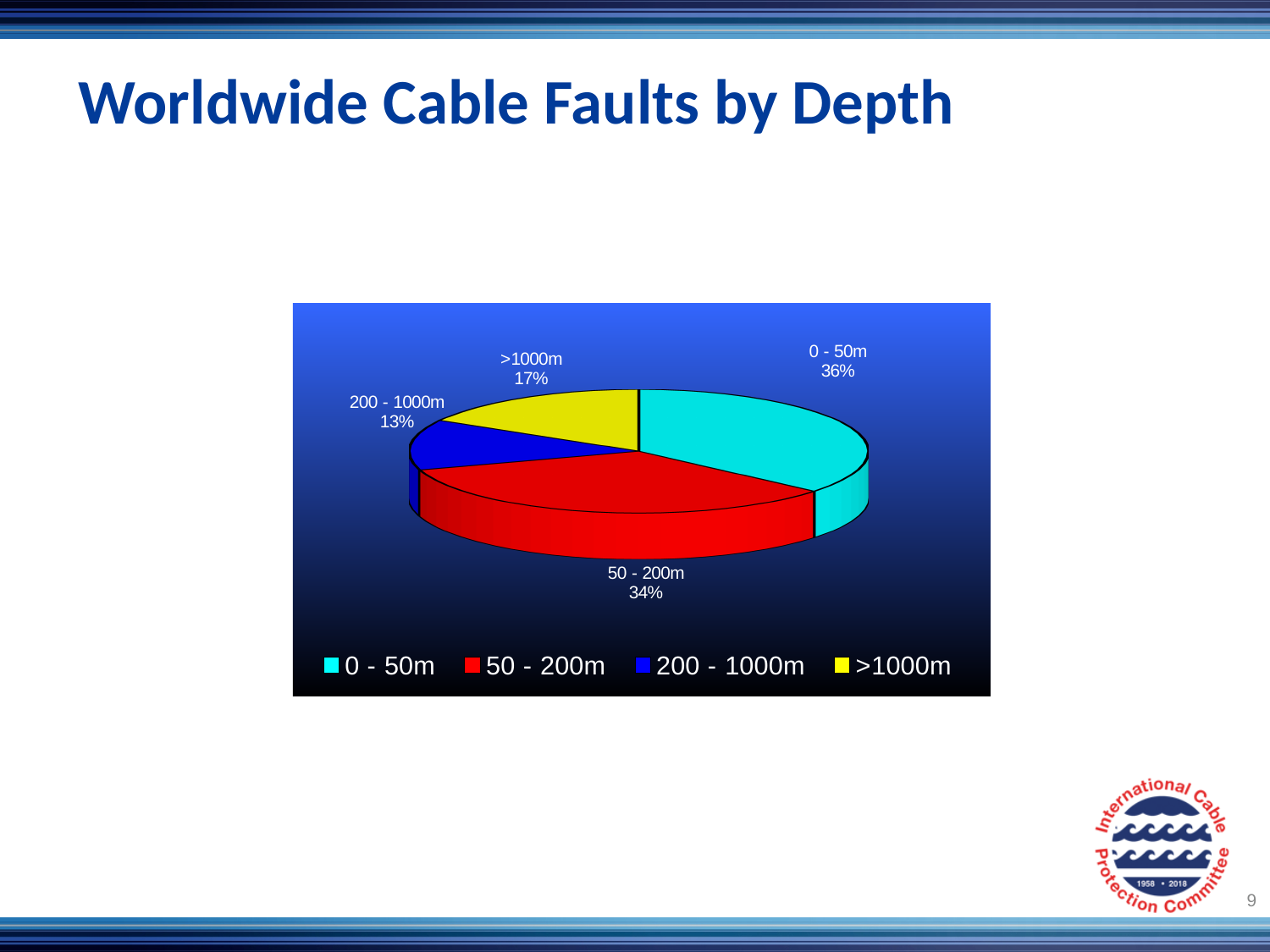
What share of worldwide cable faults occurs at depths greater than 1000m? 17% Which depth range accounts for the smallest share of cable faults? 200 - 1000m What kind of chart is shown on the slide? Pie chart Which has a larger share of cable faults, >1000m or 200 - 1000m? >1000m What share of worldwide cable faults occurs at 0 - 50m depth? 36% What share of worldwide cable faults occurs at 200 - 1000m depth? 13% Which depth range accounts for the largest share of cable faults? 0 - 50m What share of worldwide cable faults occurs at 50 - 200m depth? 34% How many depth categories are shown in the pie chart? 4 What colour represents the 50 - 200m slice in the pie chart? Red What is the difference in percentage points between the 0 - 50m and 50 - 200m shares? 2 percentage points What is the difference in percentage points between the >1000m and 200 - 1000m shares? 4 percentage points